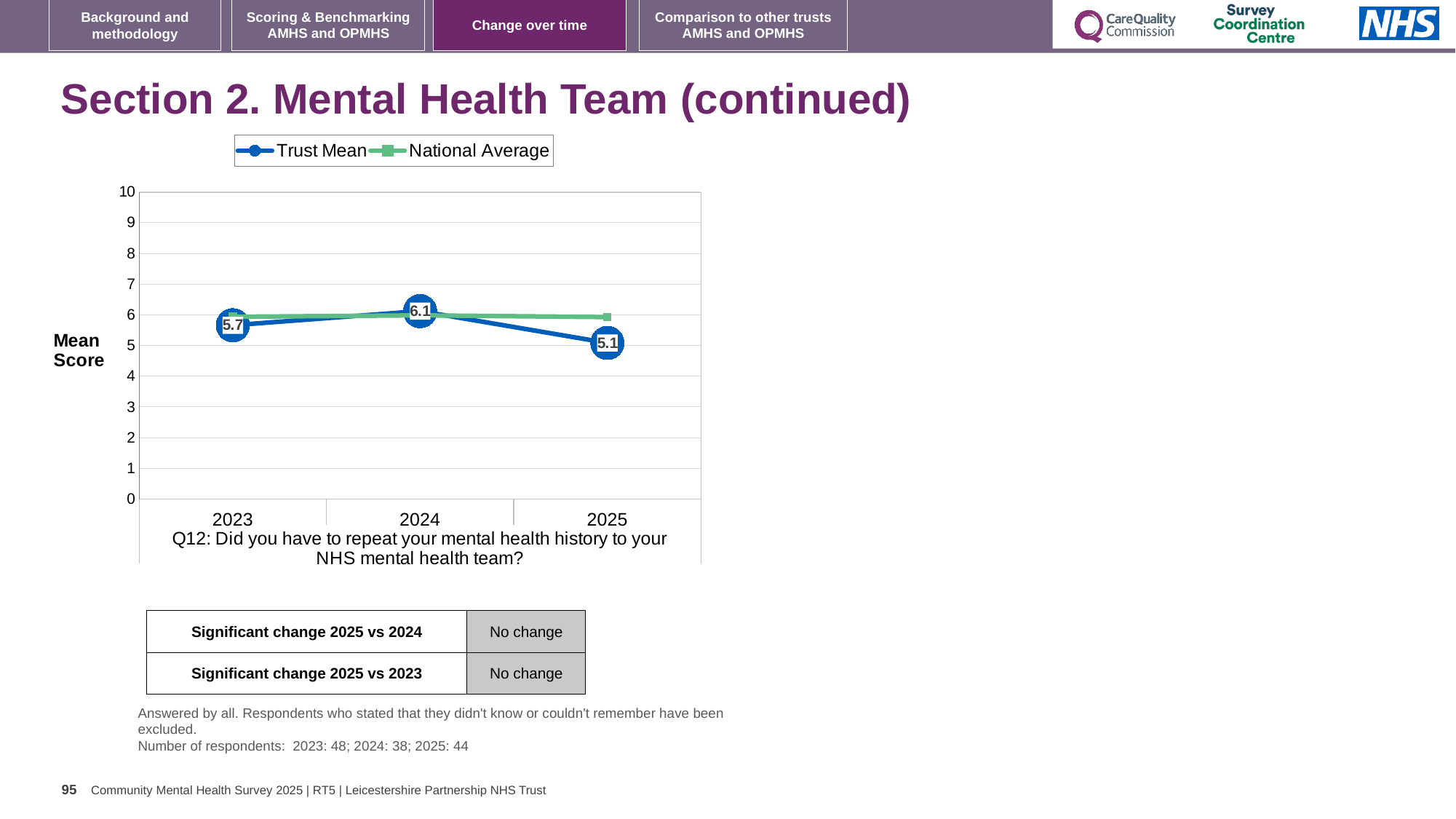
What kind of chart is shown on the slide? Line chart What is the Trust Mean score for 2025? 5.1 Does the Trust Mean rise or fall from 2024 to 2025? Fall Which is larger, the Trust Mean in 2023 or in 2025? 2023 In which year is the Trust Mean highest? 2024 Is the National Average value for 2025 greater or less than 5? greater How many series does the legend list? 2 What is the Trust Mean score for 2023? 5.7 In which year is the Trust Mean lowest? 2025 How many years are shown on the x axis? 3 What is the difference between the Trust Mean in 2024 and in 2025? 1.0 What is the Trust Mean score for 2024? 6.1